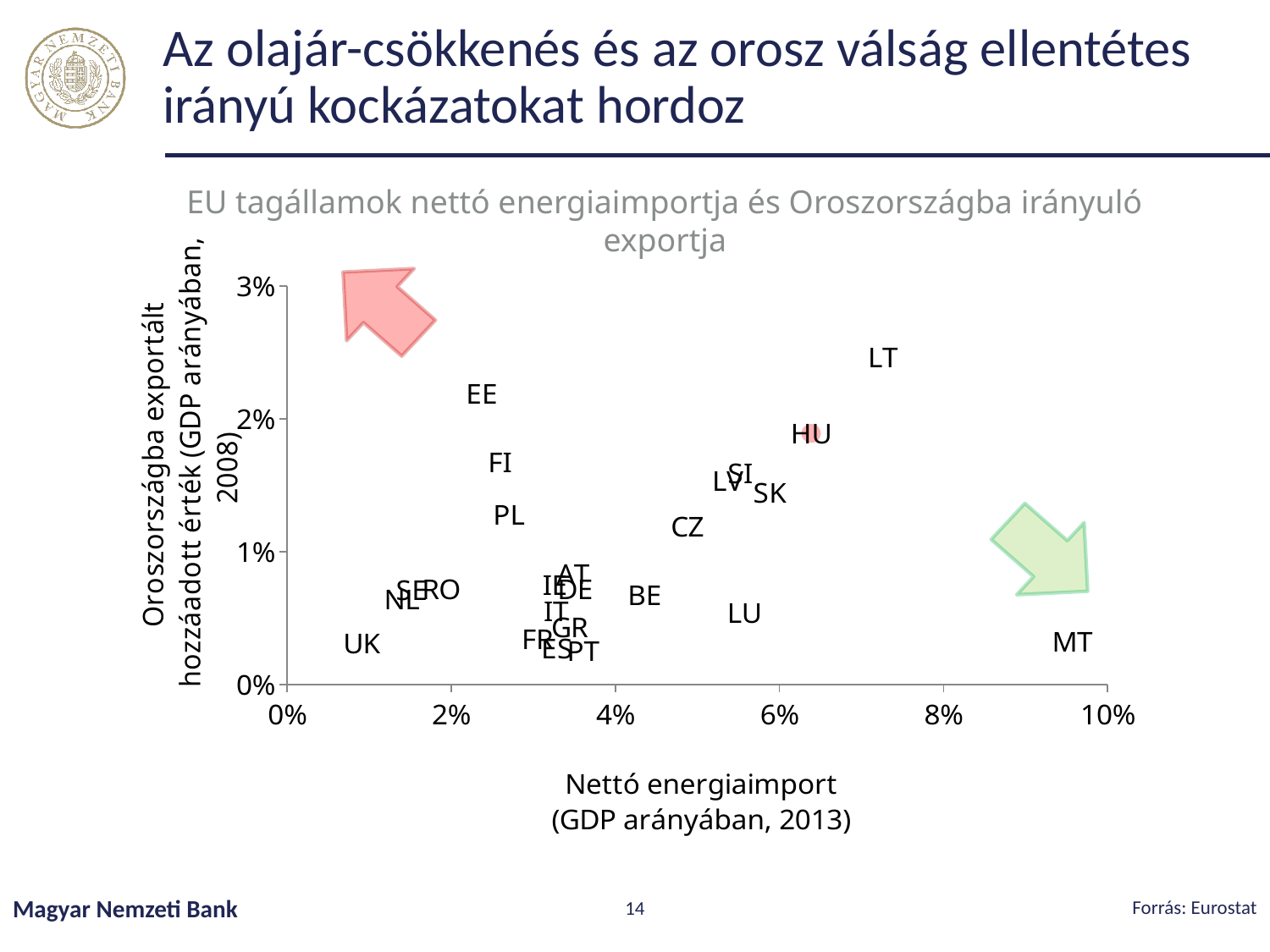
Which country has the highest value on the vertical axis (export to Russia as share of GDP)? LT What is the label of the x axis of the chart? Nettó energiaimport (GDP arányában, 2013) Which country has the lowest net energy import (furthest left on the x axis)? UK Is the net energy import (x axis) for UK greater or less than 2%? less Is the vertical-axis value for LU greater or less than 1%? less Which has a higher vertical-axis value, HU or CZ? HU Which country has the highest net energy import (furthest right on the x axis)? MT Which has a higher vertical-axis value, LT or EE? LT What kind of chart is shown on the slide? scatter chart Is the vertical-axis value for LT greater or less than 2%? greater What is the title of the chart? EU tagállamok nettó energiaimportja és Oroszországba irányuló exportja